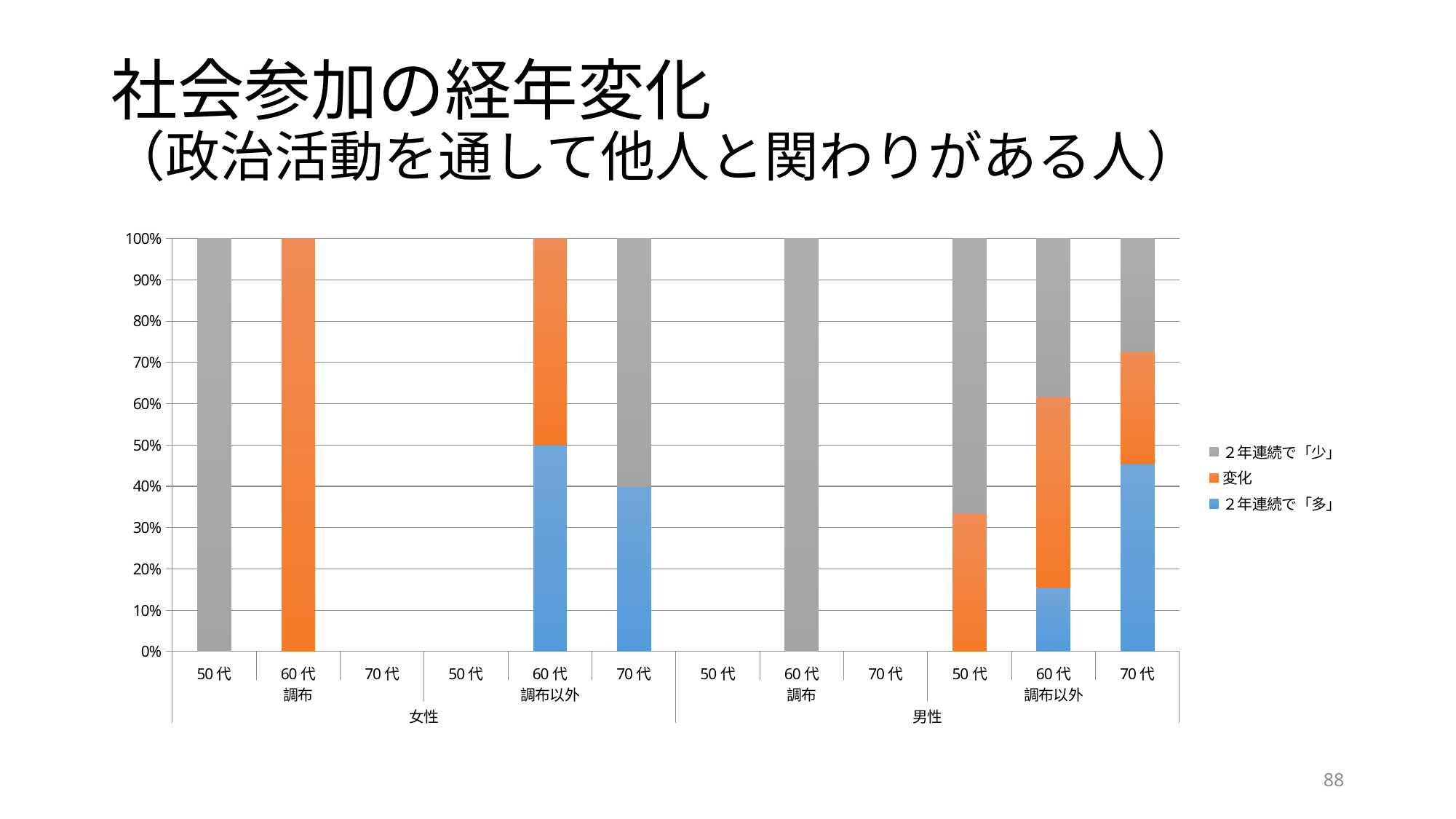
What share of the bar for 女性 調布以外 70代 is ２年連続で「多」? 40% Is the ２年連続で「少」 share for 男性 調布以外 50代 greater or less than 60%? greater What share of the bar for 女性 調布以外 60代 is ２年連続で「多」? 50% How many age-group categories are shown along the x axis? 12 What share of the bar for 女性 調布 50代 is ２年連続で「少」? 100% Which has a larger ２年連続で「多」 share: 男性 調布以外 70代 or 男性 調布以外 60代? 男性 調布以外 70代 What kind of chart is shown on the slide? stacked bar chart Which series is shown in blue according to the legend? ２年連続で「多」 Is the ２年連続で「多」 share for 男性 調布以外 60代 greater or less than 20%? less How many series does the legend list? 3 What share of the bar for 女性 調布 60代 is 変化? 100% Among the 男性 調布以外 bars, which age group has the largest ２年連続で「多」 share? 70代